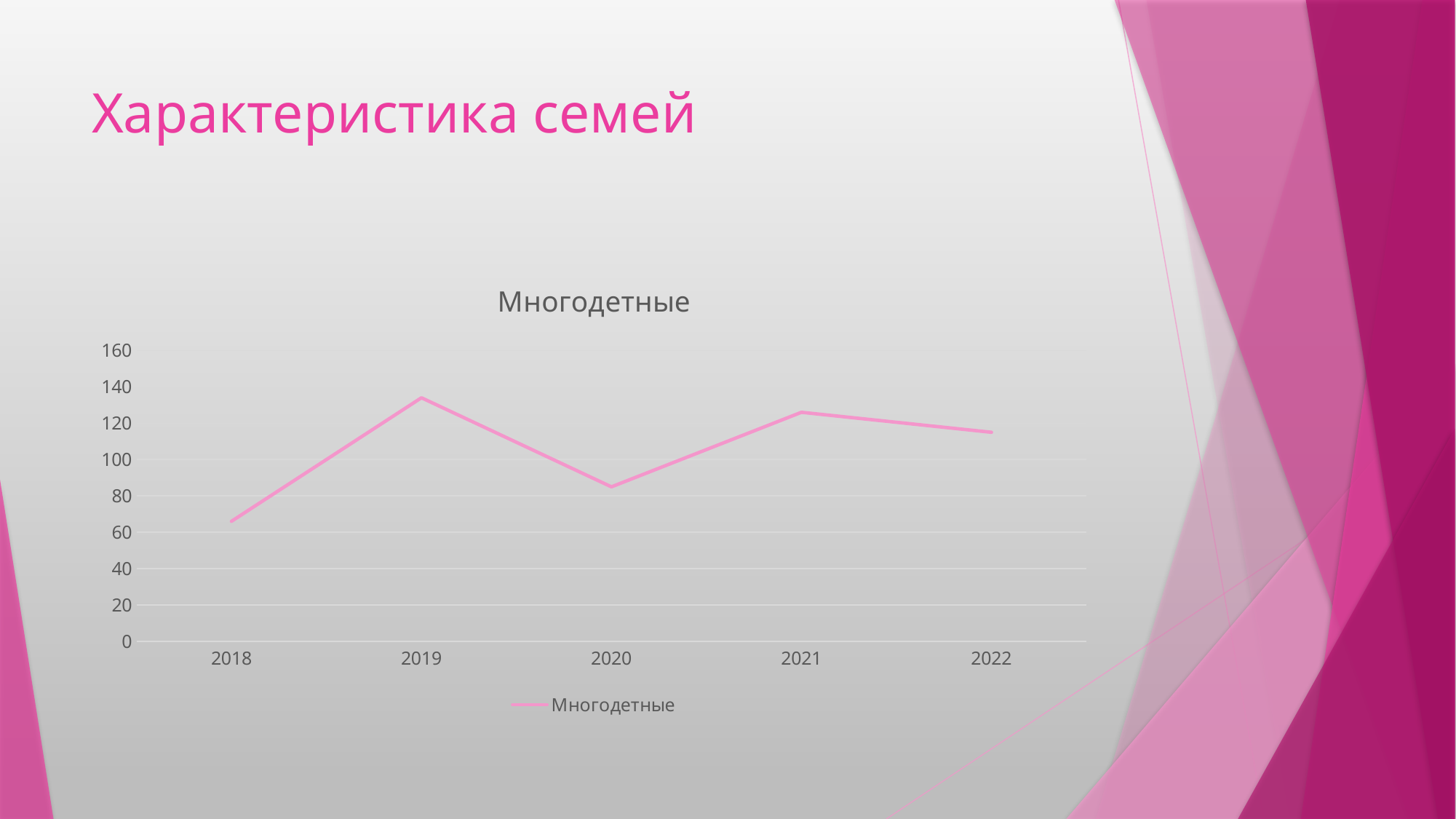
Which year has the highest value on the chart? 2019 Which year has the lowest value on the chart? 2018 Is the value for 2020 greater or less than 100? less Is the value for 2019 greater or less than 120? greater Does the value rise or fall from 2019 to 2020? fall Is the value for 2018 greater or less than 80? less What is the title of the chart? Многодетные How many years are plotted on the x axis of the chart? 5 How many series does the legend list? 1 What kind of chart is shown on the slide? line chart Which year has the larger value, 2018 or 2020? 2020